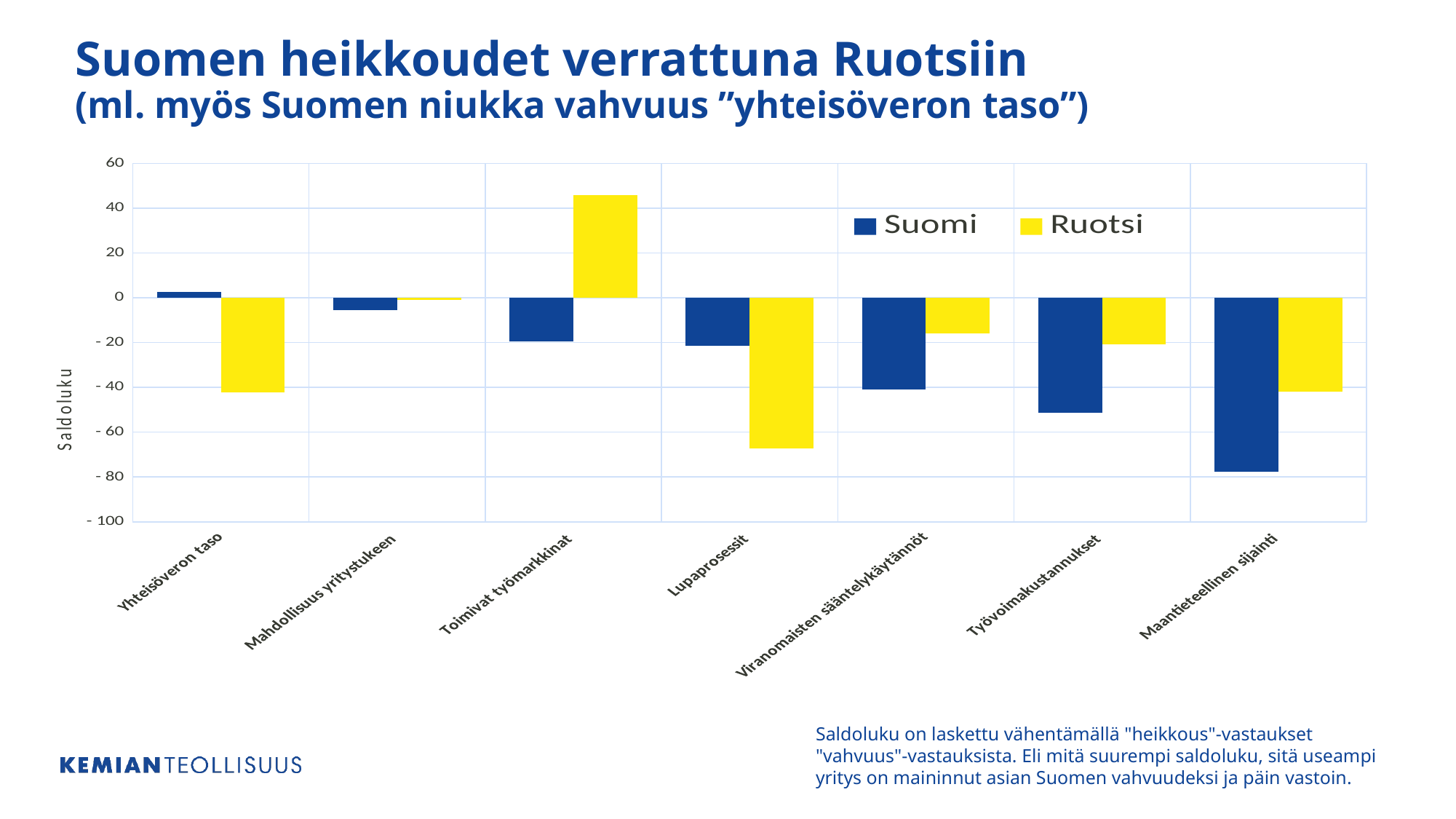
Which category has the highest value for Ruotsi? Toimivat työmarkkinat Is the value for Ruotsi in Toimivat työmarkkinat greater or less than 40? greater Which category has the lowest value for Suomi? Maantieteellinen sijainti What kind of chart is shown on the slide? bar chart For Maantieteellinen sijainti, which series has the larger value, Suomi or Ruotsi? Ruotsi What is the label of the vertical axis? Saldoluku Is the value for Suomi in Työvoimakustannukset greater or less than -40? less Is the value for Suomi in Maantieteellinen sijainti greater or less than -60? less For Lupaprosessit, which series has the larger value, Suomi or Ruotsi? Suomi How many categories are shown on the x axis? 7 Which category has the lowest value for Ruotsi? Lupaprosessit How many series does the legend list? 2